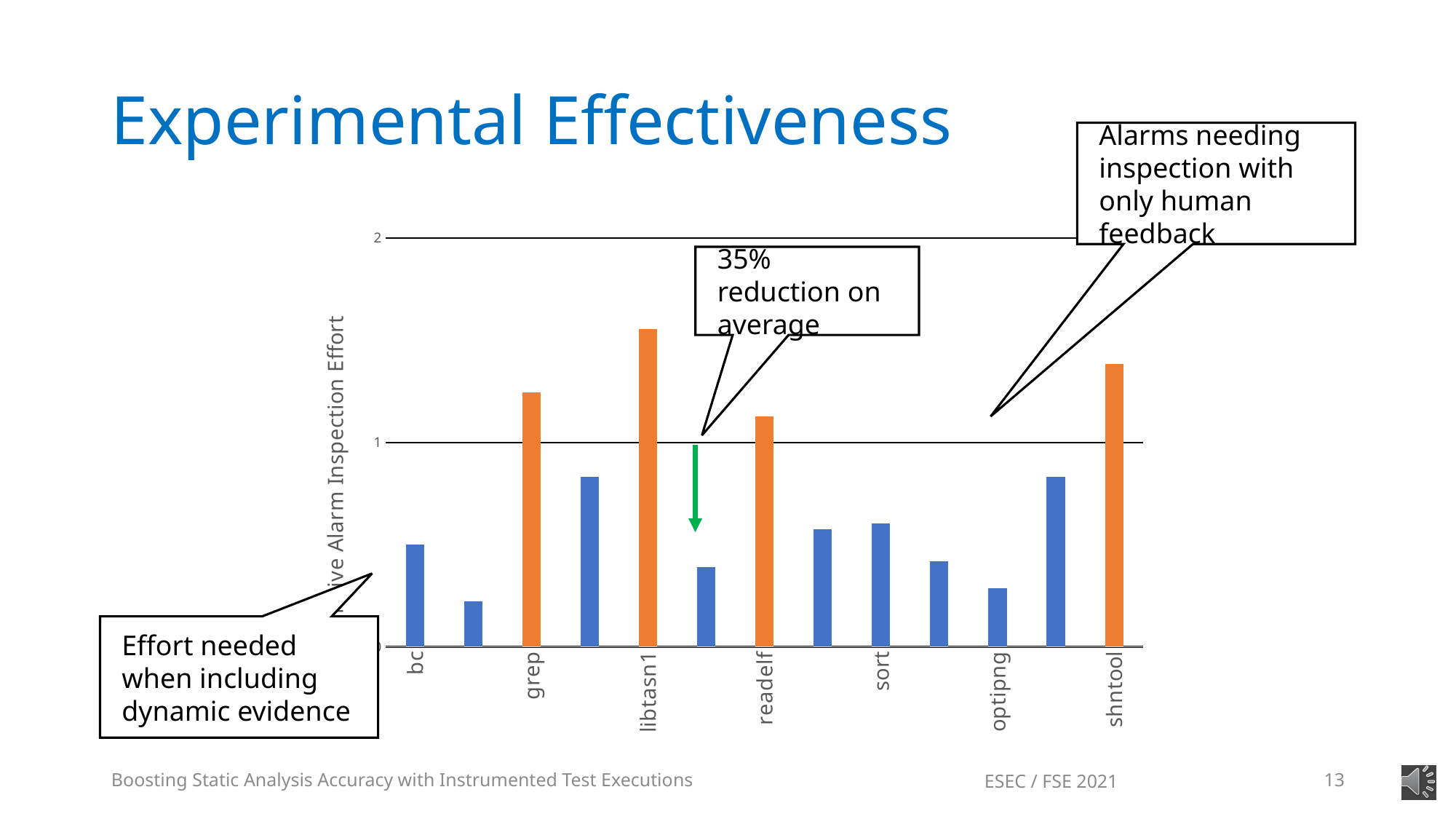
Is the value of the orange bar for libtasn1 greater or less than 1? greater Is the value of the orange bar for shntool greater or less than 1? greater Is the value of the blue bar for bc greater or less than 1? less Which is taller, the orange bar for grep or the orange bar for readelf? grep Which labelled category has the tallest bar in the chart? libtasn1 How many orange bars are in the chart? 4 According to the annotation on the chart, what is the average reduction? 35% How many bars are plotted in the chart in total? 13 What kind of chart is shown on the slide? bar chart Which is taller, the orange bar for libtasn1 or the orange bar for shntool? libtasn1